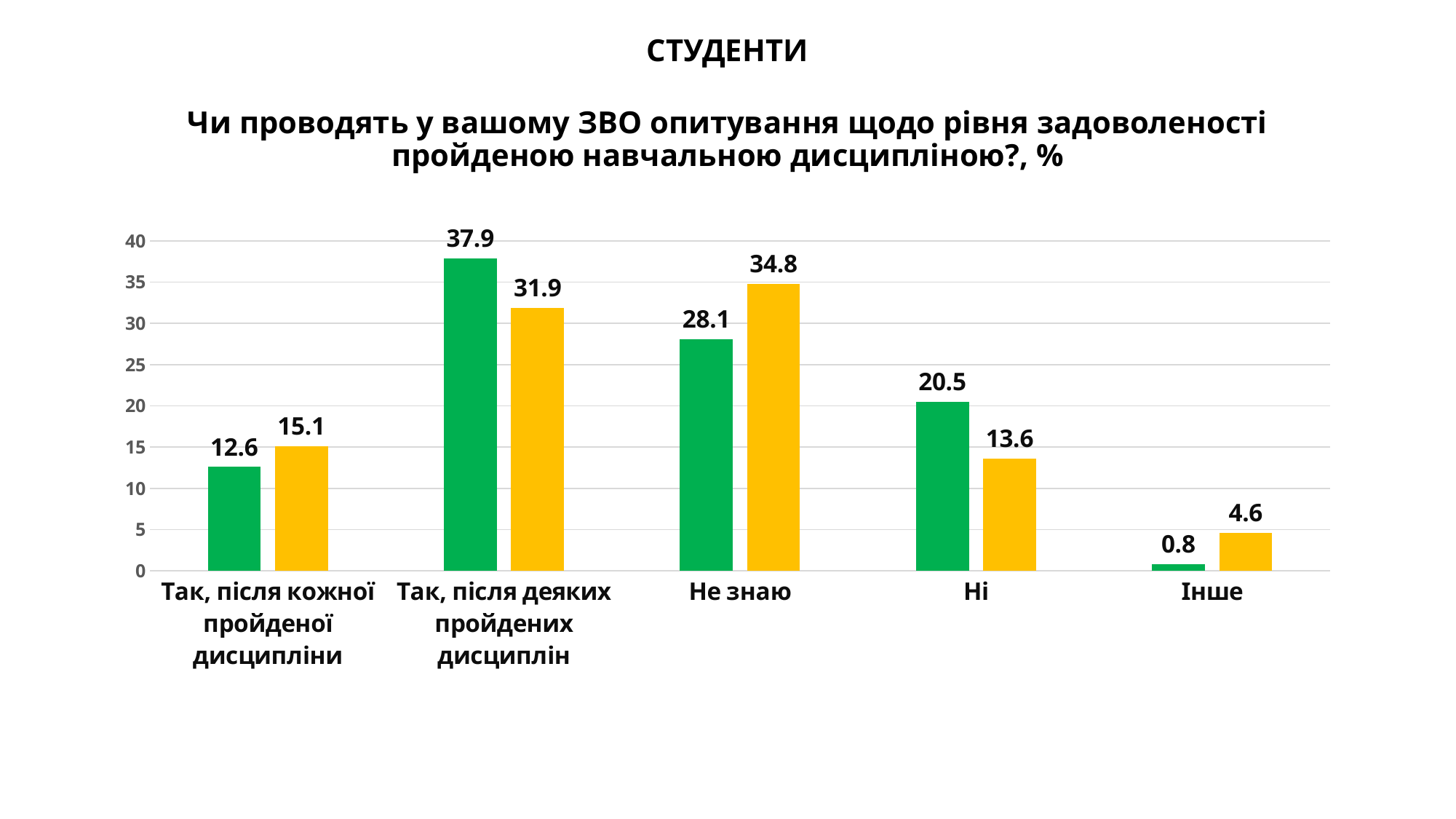
What is the value of the yellow bar for "Інше"? 4.6 For "Не знаю", which bar is larger, the green or the yellow one? yellow What is the difference between the green and yellow bars for "Ні"? 6.9 Is the green bar for "Ні" greater or less than 20? greater Which category has the lowest yellow bar? Інше What is the value of the green bar for "Не знаю"? 28.1 Which category has the highest green bar? Так, після деяких пройдених дисциплін What is the heading shown above the chart title? СТУДЕНТИ What is the difference between the green bars for "Так, після деяких пройдених дисциплін" and "Так, після кожної пройденої дисципліни"? 25.3 What kind of chart is shown on the slide? bar chart What is the value of the yellow bar for "Так, після деяких пройдених дисциплін"? 31.9 How many categories are shown on the x axis? 5